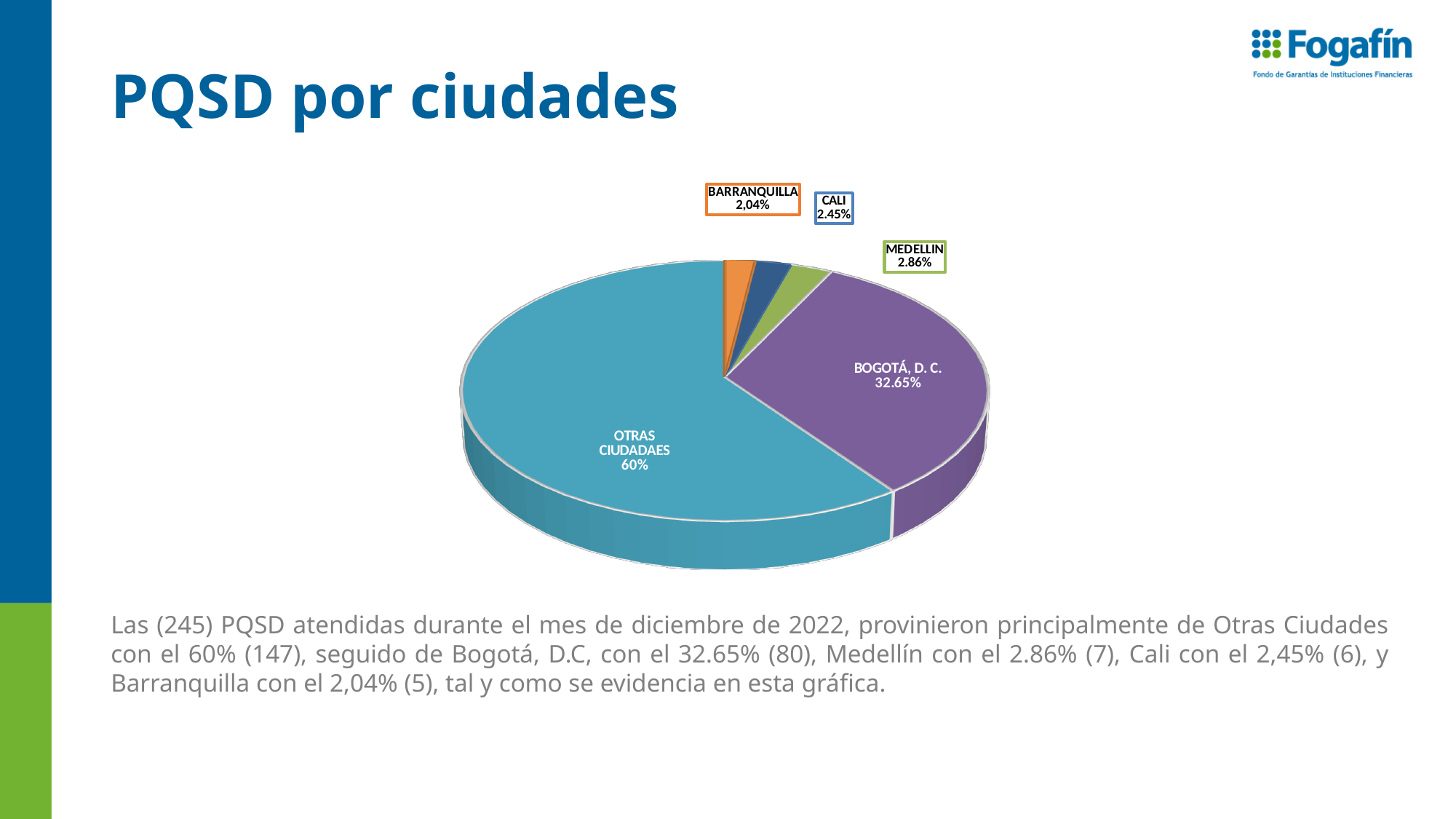
What share of the pie does CALI have? 2.45% What colour is the BOGOTÁ, D. C. slice? Purple How many slices does the pie chart have? 5 Which slice is larger, BOGOTÁ, D. C. or MEDELLIN? BOGOTÁ, D. C. Which category has the largest slice of the pie? OTRAS CIUDADAES What share of the pie does MEDELLIN have? 2.86% Which category has the smallest slice of the pie? BARRANQUILLA What is the difference in percentage points between the OTRAS CIUDADAES slice and the BOGOTÁ, D. C. slice? 27.35 What kind of chart is shown on the slide? Pie chart What share of the pie does BARRANQUILLA have? 2,04% What share of the pie does BOGOTÁ, D. C. have? 32.65% What share of the pie does OTRAS CIUDADAES have? 60%